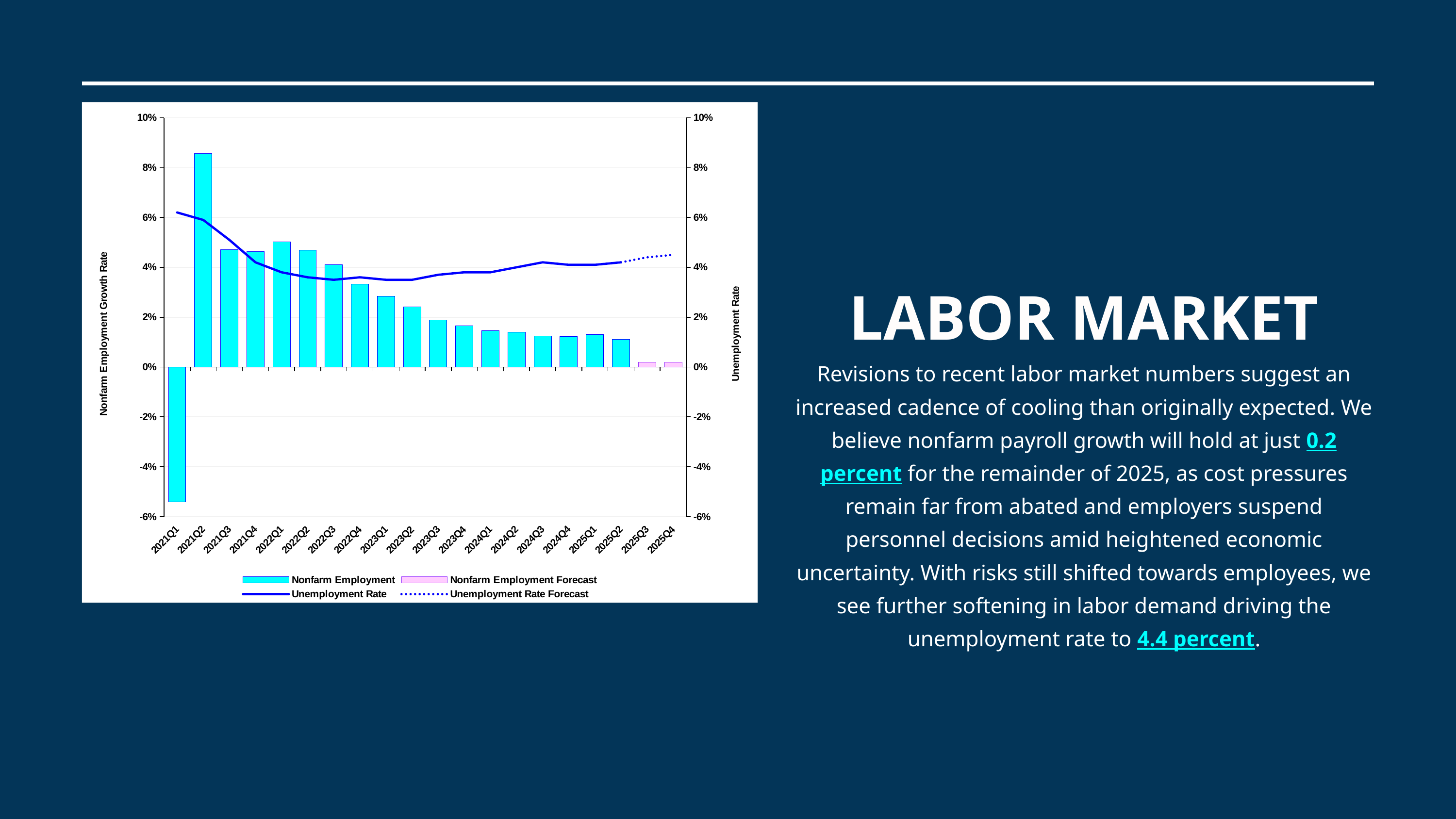
Do the Nonfarm Employment bars rise or fall from 2021Q2 to 2025Q2? fall Which quarter has the highest Nonfarm Employment bar? 2021Q2 Which quarter has the lowest Nonfarm Employment bar? 2021Q1 Is the Nonfarm Employment value for 2021Q1 greater or less than -4%? less Which is larger, the Nonfarm Employment bar for 2021Q3 or for 2023Q2? 2021Q3 How many quarters are shown on the x axis of the chart? 20 Is the Unemployment Rate for 2023Q1 greater or less than 4%? less Is the Nonfarm Employment value for 2021Q2 greater or less than 8%? greater How many series does the chart's legend list? 4 What is the title of the left vertical axis of the chart? Nonfarm Employment Growth Rate What kind of chart is shown on the slide? A combined bar and line chart